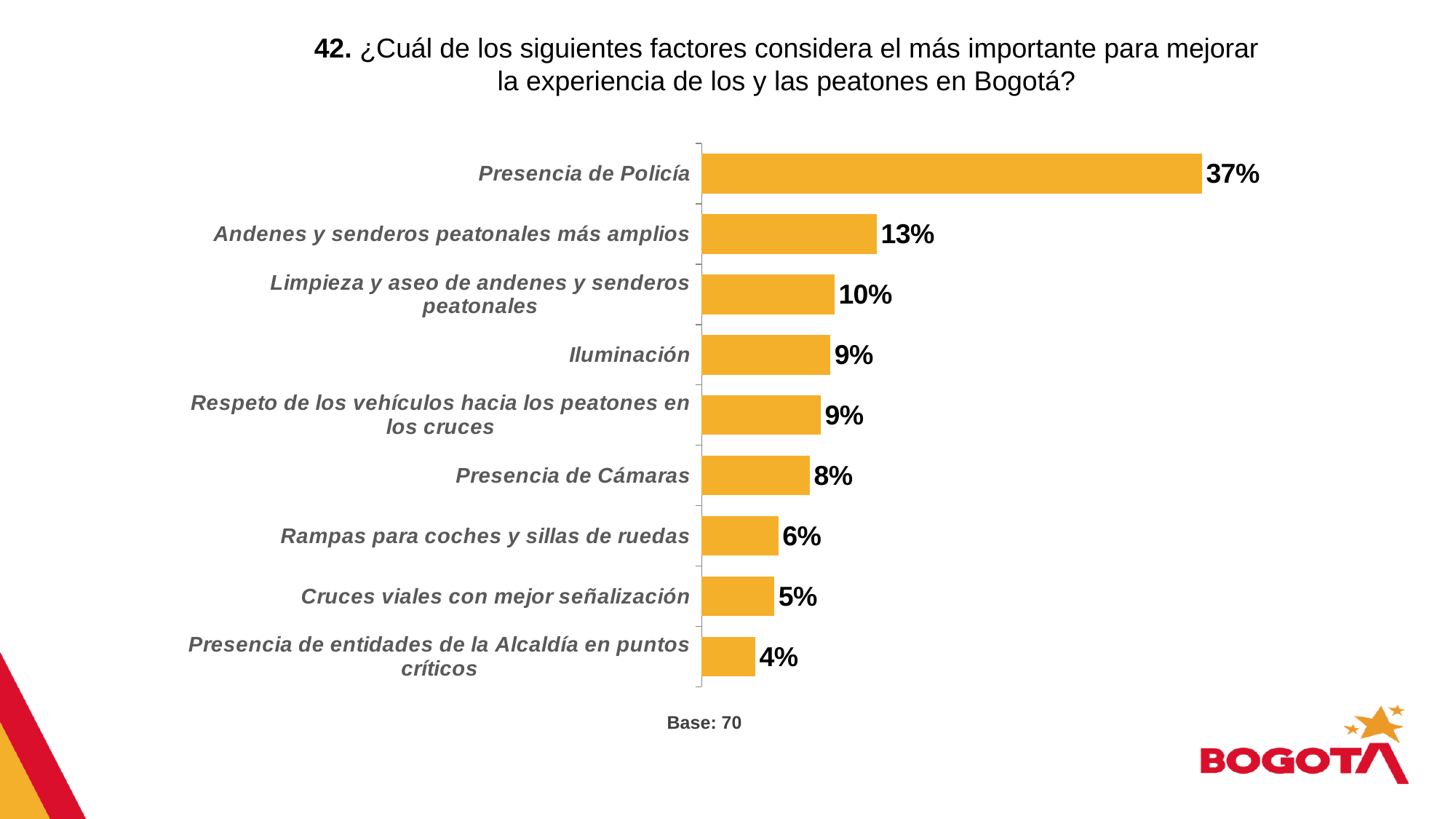
What percentage is shown for "Presencia de Cámaras"? 8% What base (number of respondents) is indicated below the chart? Base: 70 Which is larger: the value for "Rampas para coches y sillas de ruedas" or for "Cruces viales con mejor señalización"? Rampas para coches y sillas de ruedas What is the difference between "Limpieza y aseo de andenes y senderos peatonales" and "Cruces viales con mejor señalización"? 5% Which factor has the highest percentage? Presencia de Policía What is the value for "Presencia de entidades de la Alcaldía en puntos críticos"? 4% What percentage is shown for "Presencia de Policía"? 37% Which factor has the lowest percentage? Presencia de entidades de la Alcaldía en puntos críticos What is the value for "Andenes y senderos peatonales más amplios"? 13% How many factors (categories) are shown in the chart? 9 What is the difference between the values for "Presencia de Policía" and "Andenes y senderos peatonales más amplios"? 24% What type of chart is shown on the slide? Bar chart